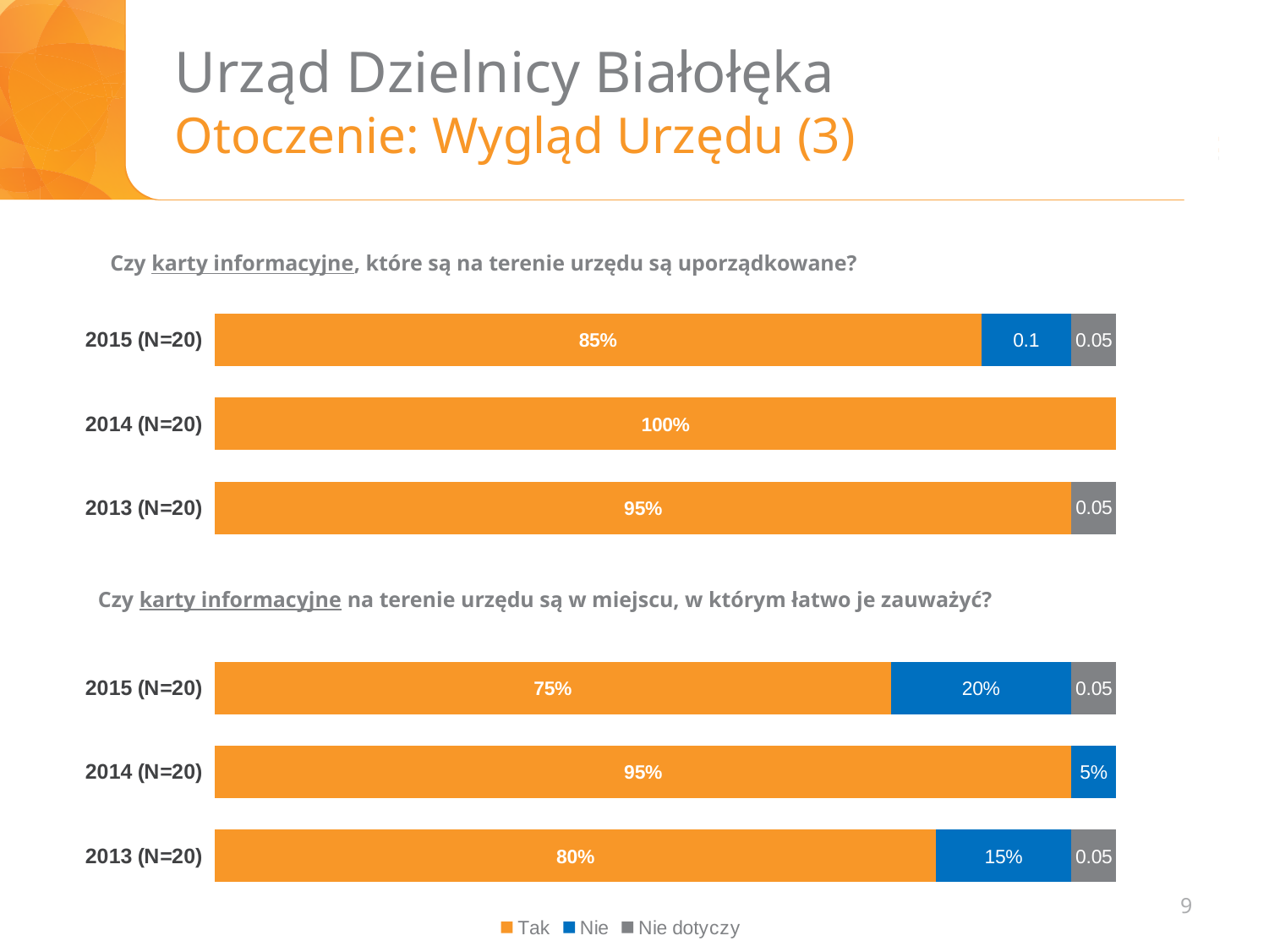
In the top chart (Czy karty informacyjne, które są na terenie urzędu są uporządkowane?), which year has the highest Tak value? 2014 (N=20) In the bottom chart (Czy karty informacyjne na terenie urzędu są w miejscu, w którym łatwo je zauważyć?), which year has the lowest Tak value? 2015 (N=20) In the bottom chart (Czy karty informacyjne na terenie urzędu są w miejscu, w którym łatwo je zauważyć?), what is the value for Tak in 2013 (N=20)? 80% In the bottom chart (Czy karty informacyjne na terenie urzędu są w miejscu, w którym łatwo je zauważyć?), what is the difference between the Nie values for 2015 (N=20) and 2013 (N=20)? 5% In the top chart (Czy karty informacyjne, które są na terenie urzędu są uporządkowane?), what is the value for Tak in 2015 (N=20)? 85% In the top chart (Czy karty informacyjne, które są na terenie urzędu są uporządkowane?), what label is shown for the Nie segment in 2015 (N=20)? 0.1 What type of chart is the top chart (Czy karty informacyjne, które są na terenie urzędu są uporządkowane?)? Stacked bar chart In the top chart (Czy karty informacyjne, które są na terenie urzędu są uporządkowane?), what is the difference between the Tak values for 2014 (N=20) and 2015 (N=20)? 15% In the bottom chart (Czy karty informacyjne na terenie urzędu są w miejscu, w którym łatwo je zauważyć?), what is the value for Nie in 2015 (N=20)? 20% In the bottom chart (Czy karty informacyjne na terenie urzędu są w miejscu, w którym łatwo je zauważyć?), is the Tak value for 2014 (N=20) larger or smaller than the Tak value for 2013 (N=20)? larger How many series does the legend at the bottom of the slide list? 3 In the top chart (Czy karty informacyjne, które są na terenie urzędu są uporządkowane?), what is the value for Tak in 2014 (N=20)? 100%